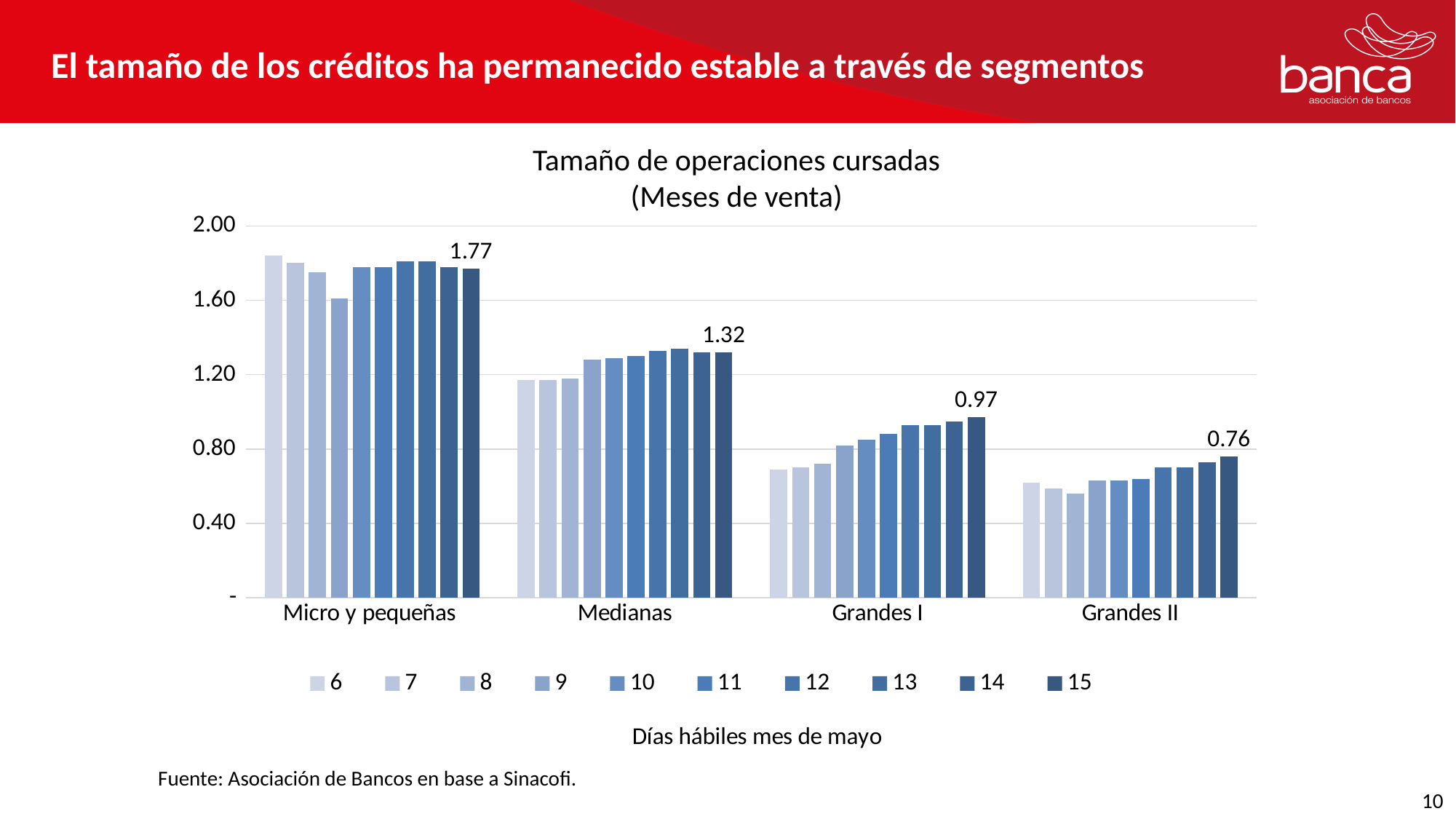
How many series does the legend list? 10 What is the difference between the series 15 values for Micro y pequeñas and Medianas? 0.45 What is the value for series 15 in the Micro y pequeñas category? 1.77 What is the value for series 15 in the Grandes I category? 0.97 Which category has the highest value for series 15? Micro y pequeñas What is the label shown below the legend on the x axis? Días hábiles mes de mayo What is the value for series 15 in the Grandes II category? 0.76 What kind of chart is shown on the slide? Bar chart Which category has the lowest value for series 15? Grandes II How many categories are shown on the x axis? 4 Is the value for series 6 in the Grandes II category greater or less than 0.80? less What is the value for series 15 in the Medianas category? 1.32